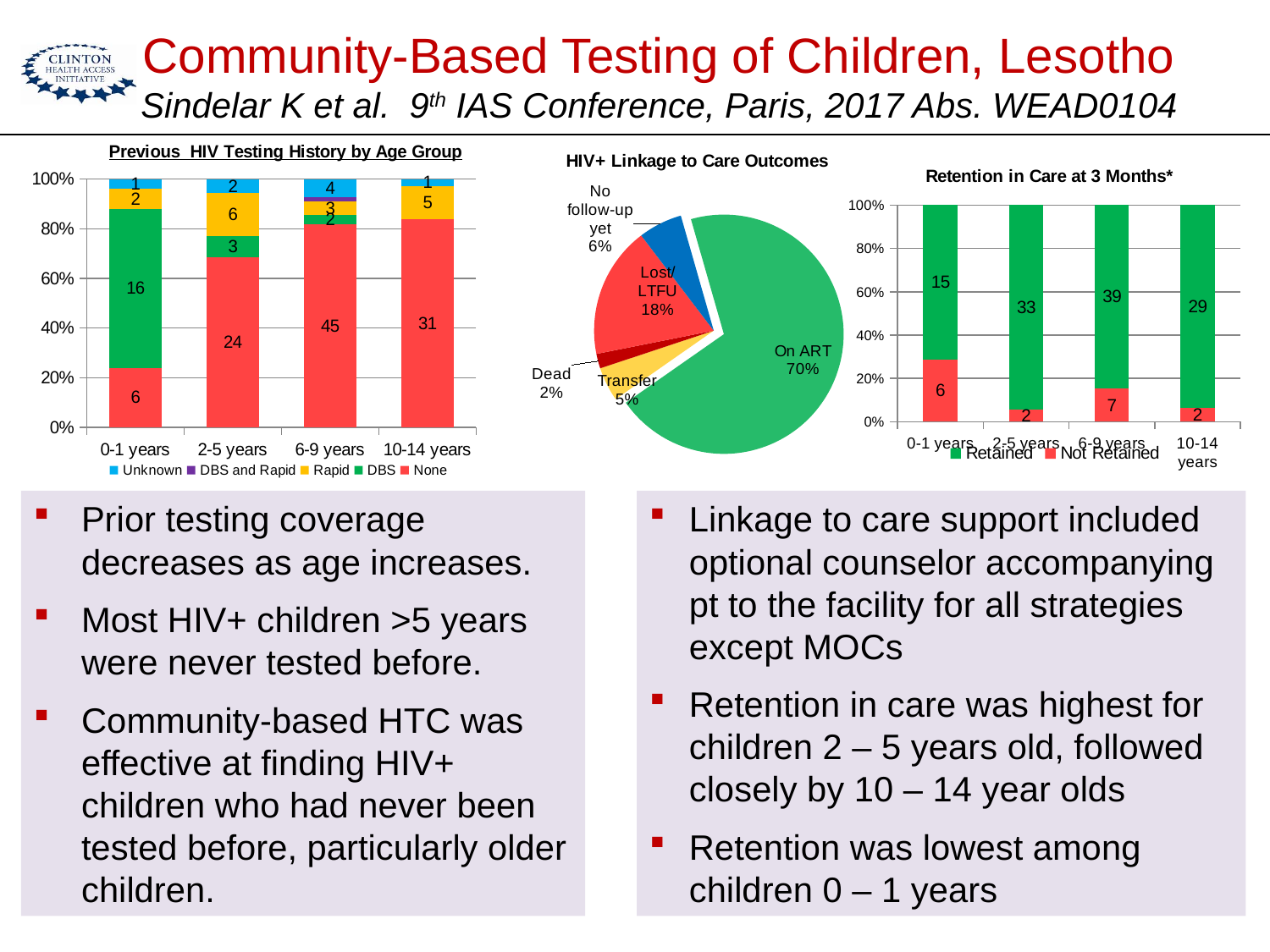
In the 'HIV+ Linkage to Care Outcomes' chart, what share of the pie is 'On ART'? 70% In the 'Retention in Care at 3 Months*' chart, what is the total of the Retained and Not Retained values for 2-5 years? 35 In the 'Previous HIV Testing History by Age Group' chart, what is the 'DBS' value for 0-1 years? 16 How many slices does the 'HIV+ Linkage to Care Outcomes' pie chart have? 5 In the 'HIV+ Linkage to Care Outcomes' chart, which outcome has the smallest slice? Dead In the 'Retention in Care at 3 Months*' chart, what is the Not Retained value for 0-1 years? 6 In the 'Retention in Care at 3 Months*' chart, what is the difference between the Retained values for 6-9 years and 10-14 years? 10 How many series does the legend of the 'Previous HIV Testing History by Age Group' chart list? 5 In the 'Retention in Care at 3 Months*' chart, what is the Retained value for 6-9 years? 39 In the 'Previous HIV Testing History by Age Group' chart, what is the 'None' value for 6-9 years? 45 How many series does the legend of the 'Retention in Care at 3 Months*' chart list? 2 In the 'HIV+ Linkage to Care Outcomes' chart, what percentage is 'Lost/LTFU'? 18%